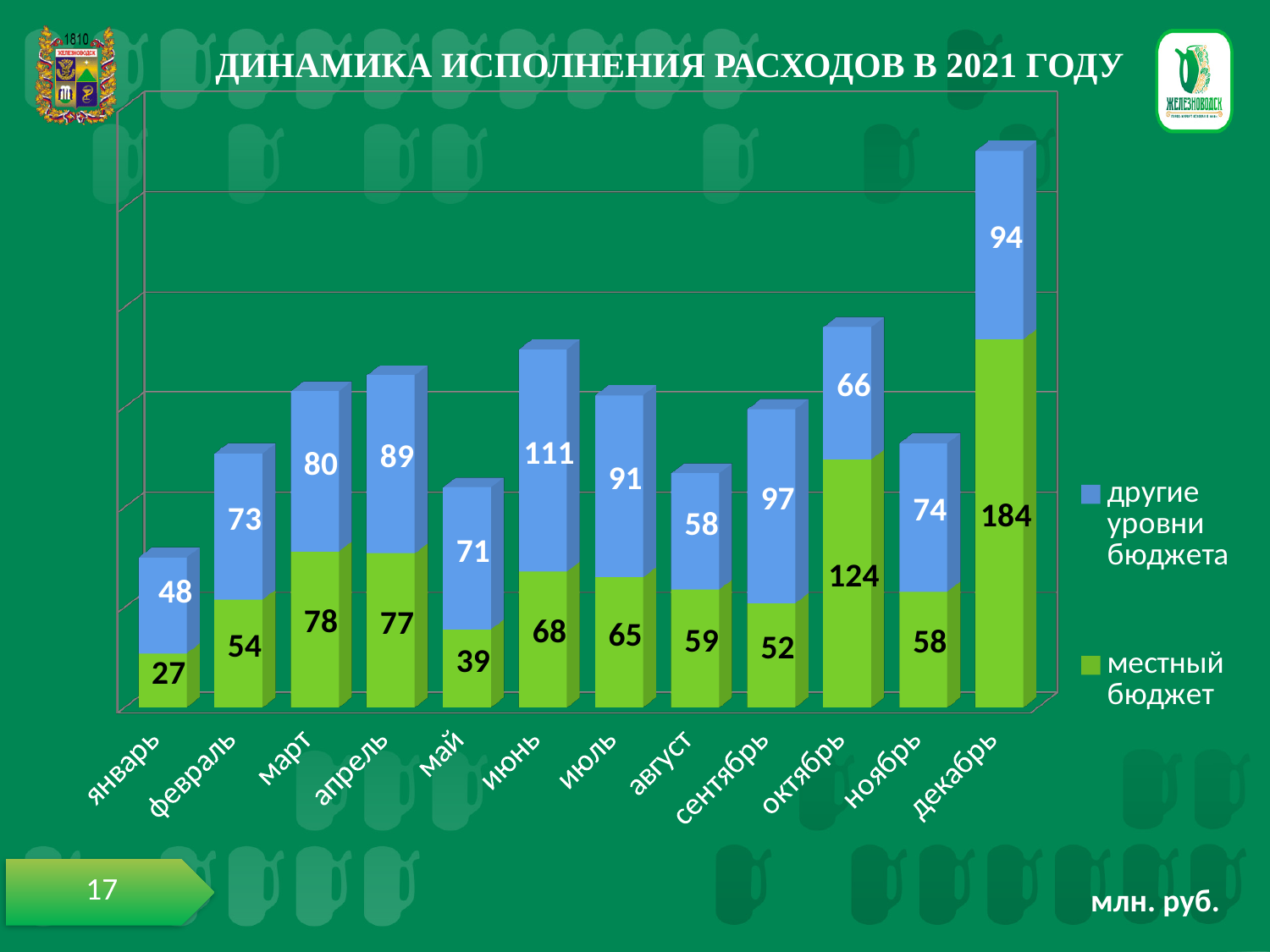
What is the value of 'местный бюджет' for май? 39 Which month has the lowest value for 'местный бюджет'? январь What is the difference between 'местный бюджет' for декабрь and for октябрь? 60 What is the total of the stacked bar for октябрь? 190 What kind of chart is shown on the slide? stacked bar chart What is the value of 'местный бюджет' for декабрь? 184 What is the value of 'другие уровни бюджета' for июнь? 111 How many series does the legend list? 2 Which month has the highest value for 'другие уровни бюджета'? июнь What is the title of the chart? ДИНАМИКА ИСПОЛНЕНИЯ РАСХОДОВ В 2021 ГОДУ Which is larger for сентябрь: 'местный бюджет' or 'другие уровни бюджета'? другие уровни бюджета How many months (categories) are shown on the x axis? 12